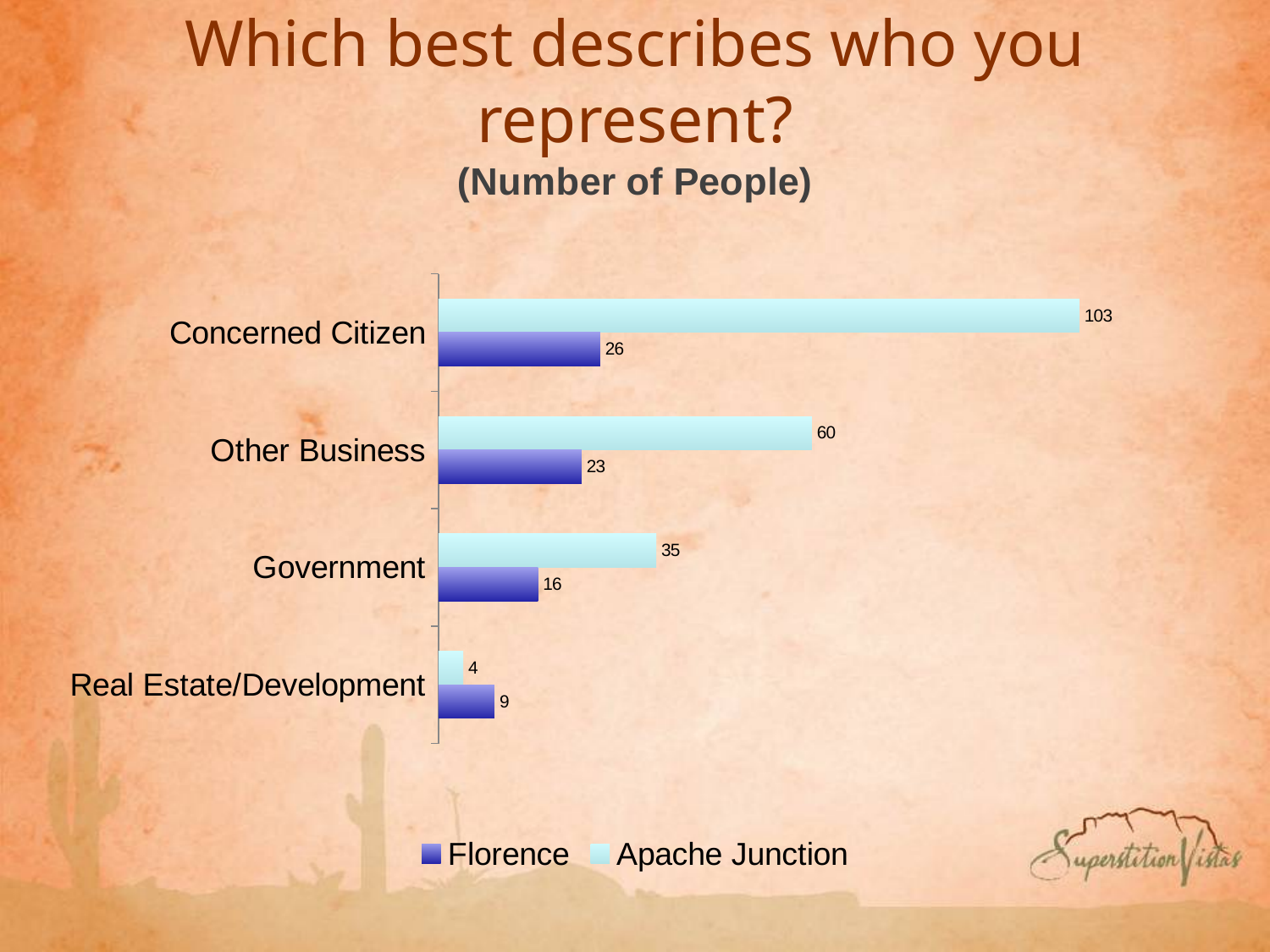
How many people from Apache Junction described themselves as a Concerned Citizen? 103 Which category has the highest value for Apache Junction? Concerned Citizen What is the difference between the Apache Junction and Florence values for Government? 19 Which category has the lowest value for Florence? Real Estate/Development Which is larger in the Real Estate/Development category: Florence or Apache Junction? Florence What kind of chart is shown on the slide? Bar chart What is the combined number of people for Concerned Citizen across both series? 129 How many series does the legend list? 2 How many categories are shown on the chart? 4 What is the value for Florence in the Other Business category? 23 What is the value for Florence in the Real Estate/Development category? 9 Which series is shown in light blue in the legend? Apache Junction